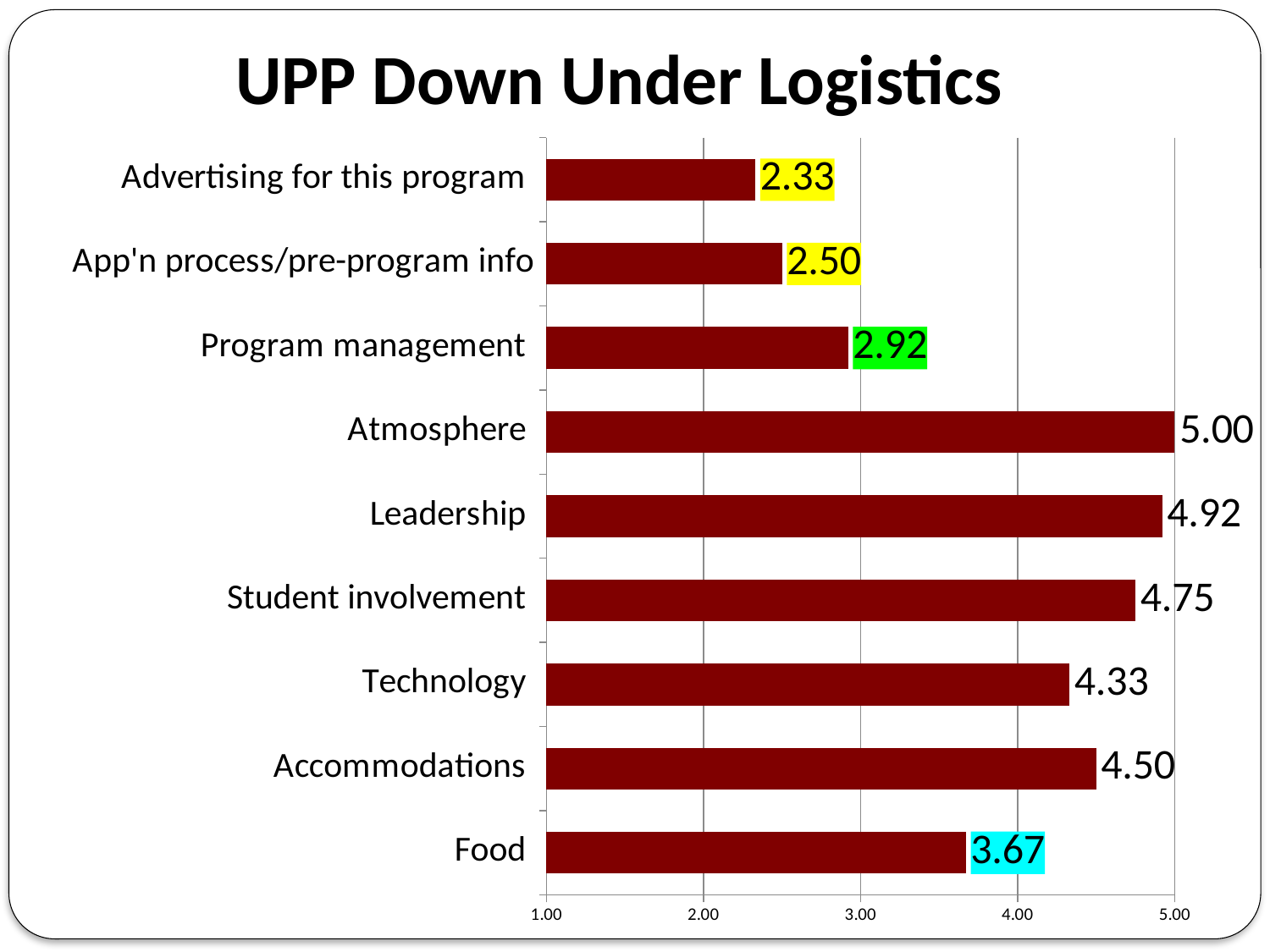
Which category has the lowest value? Advertising for this program How many categories are shown in the chart? 9 Which category has the highest value? Atmosphere What is the value for Food? 3.67 What is the value for Atmosphere? 5.00 Which is larger, the value for Leadership or the value for Student involvement? Leadership What is the title of the chart? UPP Down Under Logistics Is the value for Food greater or less than 3.00? greater What is the value for Program management? 2.92 What kind of chart is shown on the slide? bar chart What is the difference between the values for Atmosphere and Advertising for this program? 2.67 What is the difference between the values for Accommodations and Technology? 0.17